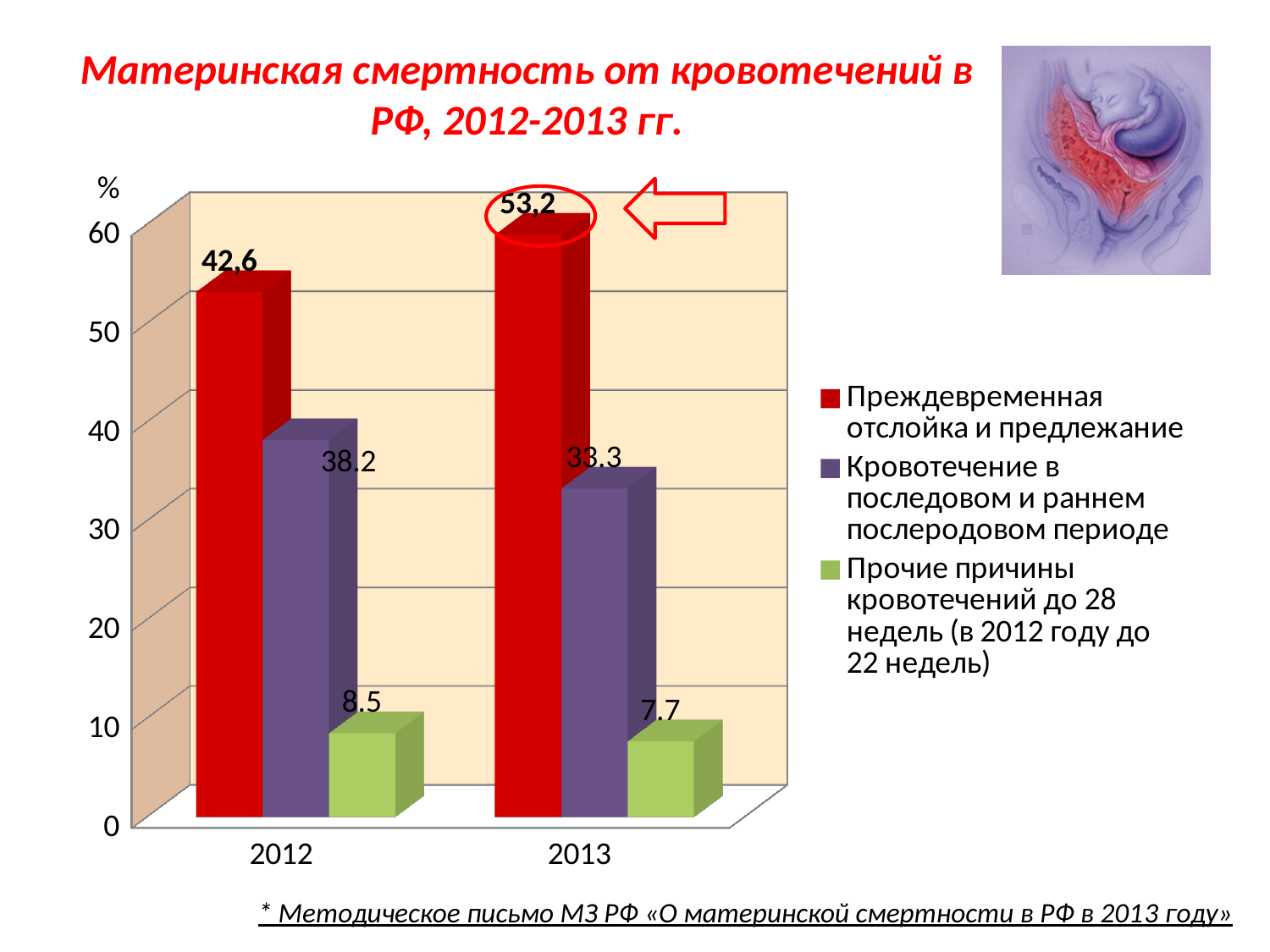
What is the value for «Преждевременная отслойка и предлежание» in 2013? 53,2 What is the value for «Прочие причины кровотечений до 28 недель» in 2012? 8.5 What is the value for «Кровотечение в последовом и раннем послеродовом периоде» in 2013? 33.3 Is the value for «Преждевременная отслойка и предлежание» in 2013 greater or less than 50? greater Which series has the highest value in 2013? Преждевременная отслойка и предлежание Does the value for «Прочие причины кровотечений до 28 недель» rise or fall from 2012 to 2013? Fall Which series has the lowest value in 2012? Прочие причины кровотечений до 28 недель (в 2012 году до 22 недель) What is the value for «Преждевременная отслойка и предлежание» in 2012? 42,6 How many series does the legend list? 3 What kind of chart is shown on the slide? Bar chart Which is larger: the value for «Кровотечение в последовом и раннем послеродовом периоде» in 2012 or in 2013? 2012 How many years (categories) are shown on the x axis? 2